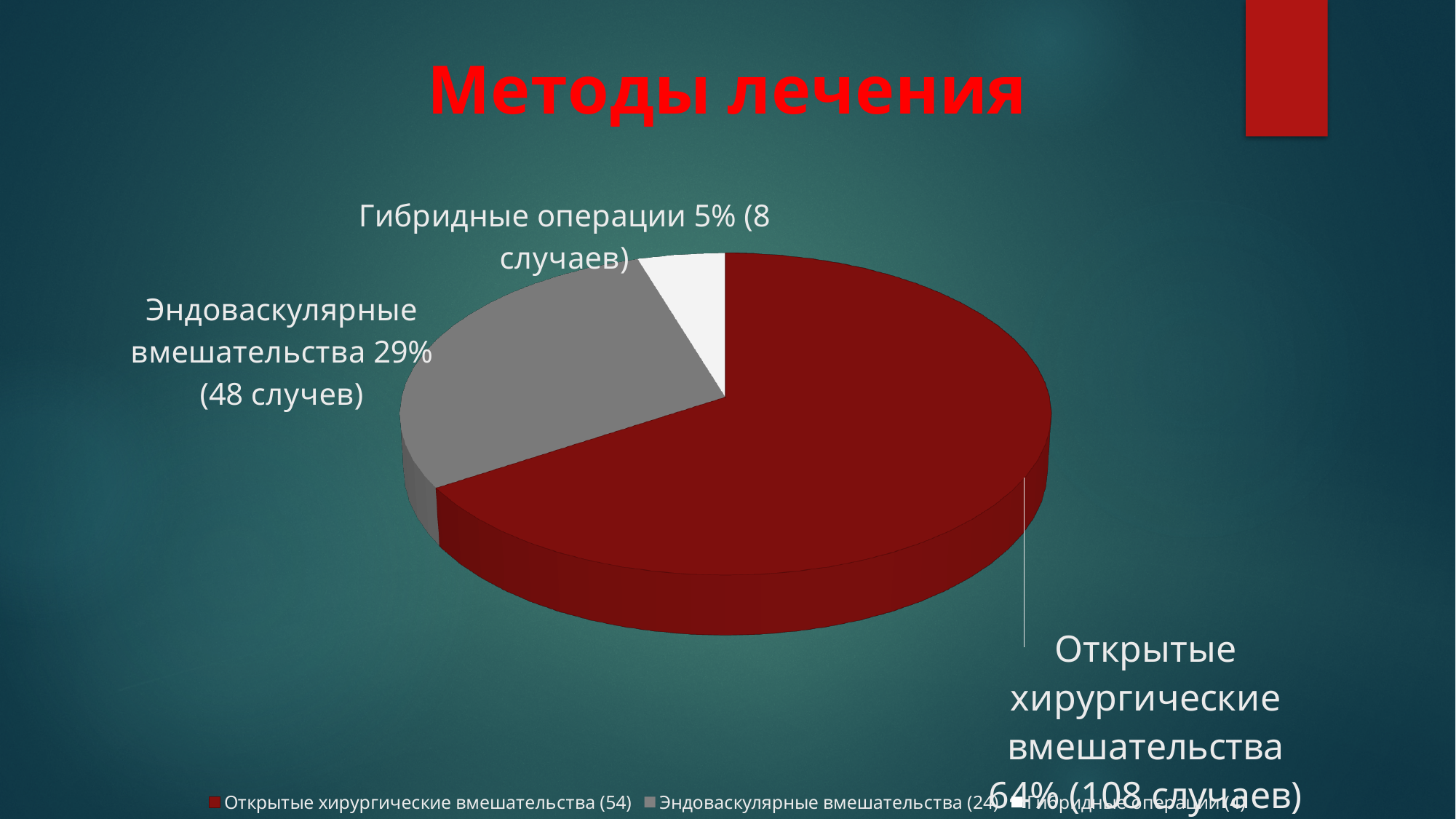
What is the title of the chart on the slide? Методы лечения What percentage share is shown for Открытые хирургические вмешательства? 64% What kind of chart is shown on the slide? Pie chart What is the difference in percentage points between Открытые хирургические вмешательства and Эндоваскулярные вмешательства? 35 Which colour is used for the Эндоваскулярные вмешательства slice? Grey Which category has the smallest slice of the pie? Гибридные операции Which category has the largest slice of the pie? Открытые хирургические вмешательства How many cases are shown for Открытые хирургические вмешательства? 108 How many slices does the pie chart have? 3 How many cases are shown for Эндоваскулярные вмешательства? 48 What percentage share is shown for Гибридные операции? 5% What percentage share is shown for Эндоваскулярные вмешательства? 29%